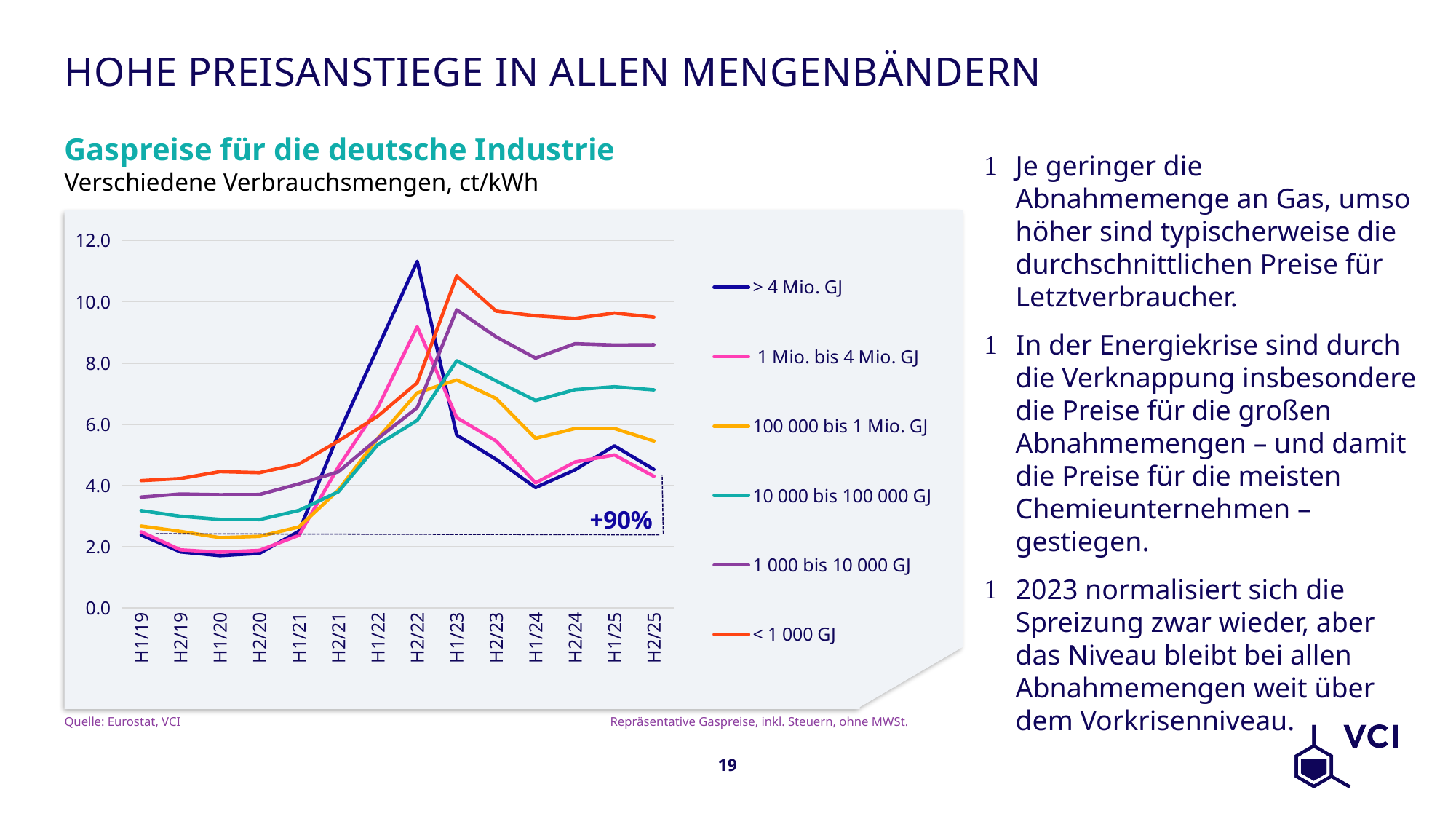
Which series has the highest value in H2/25? < 1 000 GJ Does the "> 4 Mio. GJ" line rise or fall between H1/21 and H2/22? rise Is the value for "< 1 000 GJ" in H1/23 greater or less than 10.0? greater What percentage change is annotated on the chart? +90% What unit are the gas prices shown in, according to the chart subtitle? ct/kWh Is the value for "> 4 Mio. GJ" in H2/22 greater or less than 10.0? greater How many series does the legend list? 6 In H2/22, which is larger: the value for "> 4 Mio. GJ" or the value for "< 1 000 GJ"? > 4 Mio. GJ How many time periods are shown on the x axis? 14 Is the value for "> 4 Mio. GJ" in H1/20 greater or less than 2.0? less What kind of chart is shown on the slide? line chart